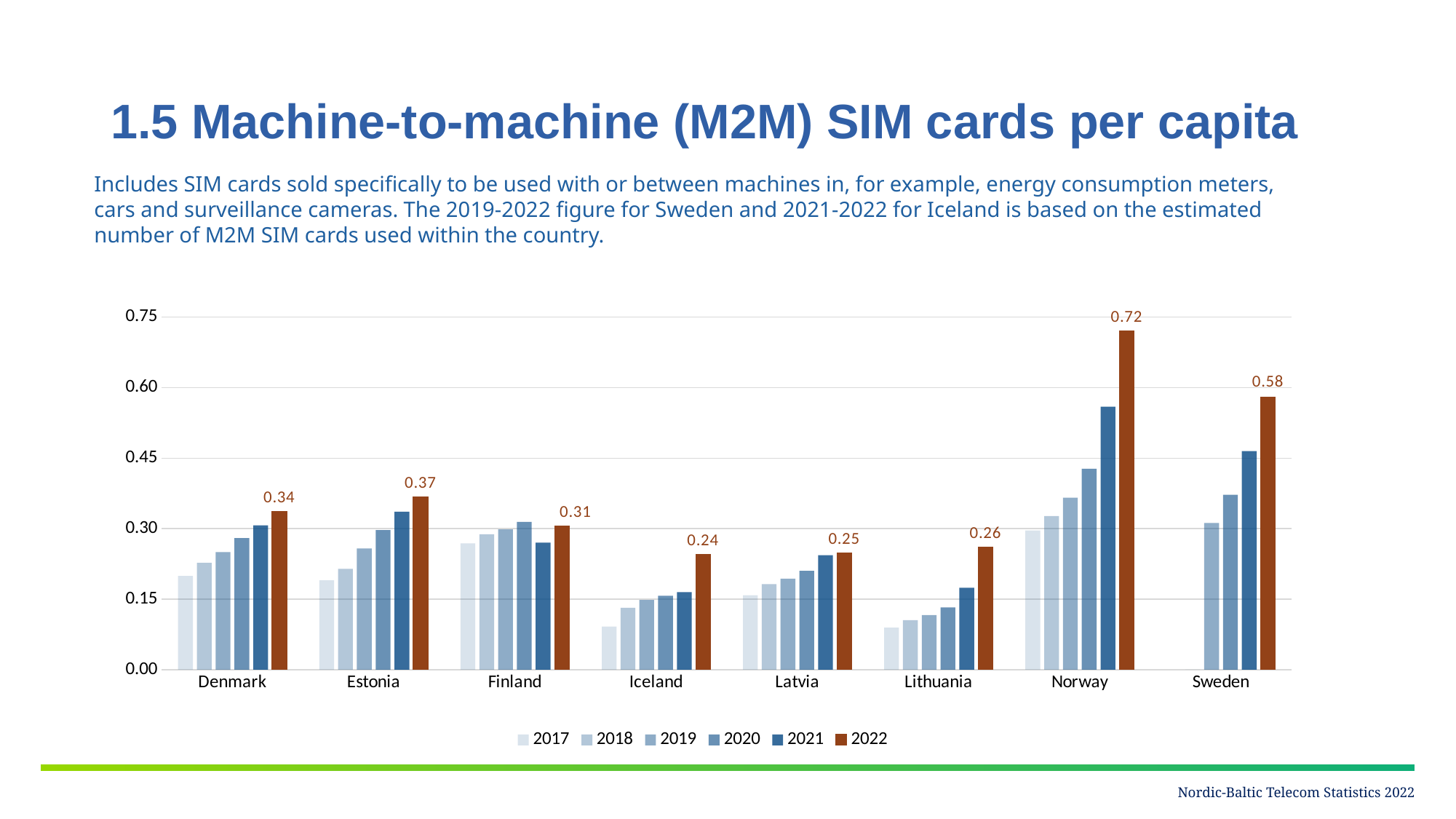
Do the values for Norway rise or fall from 2017 to 2022? rise What kind of chart is shown on the slide? bar chart Which country has the highest 2022 value? Norway What is the 2022 value for Iceland? 0.24 Which has the larger 2022 value, Estonia or Denmark? Estonia Is the 2021 value for Norway greater or less than 0.45? greater What is the 2022 value for Norway? 0.72 What is the difference between the 2022 values for Norway and Sweden? 0.14 How many series does the legend list? 6 Is the 2017 value for Lithuania greater or less than 0.15? less How many countries are shown on the x axis? 8 Which country has the lowest 2022 value? Iceland